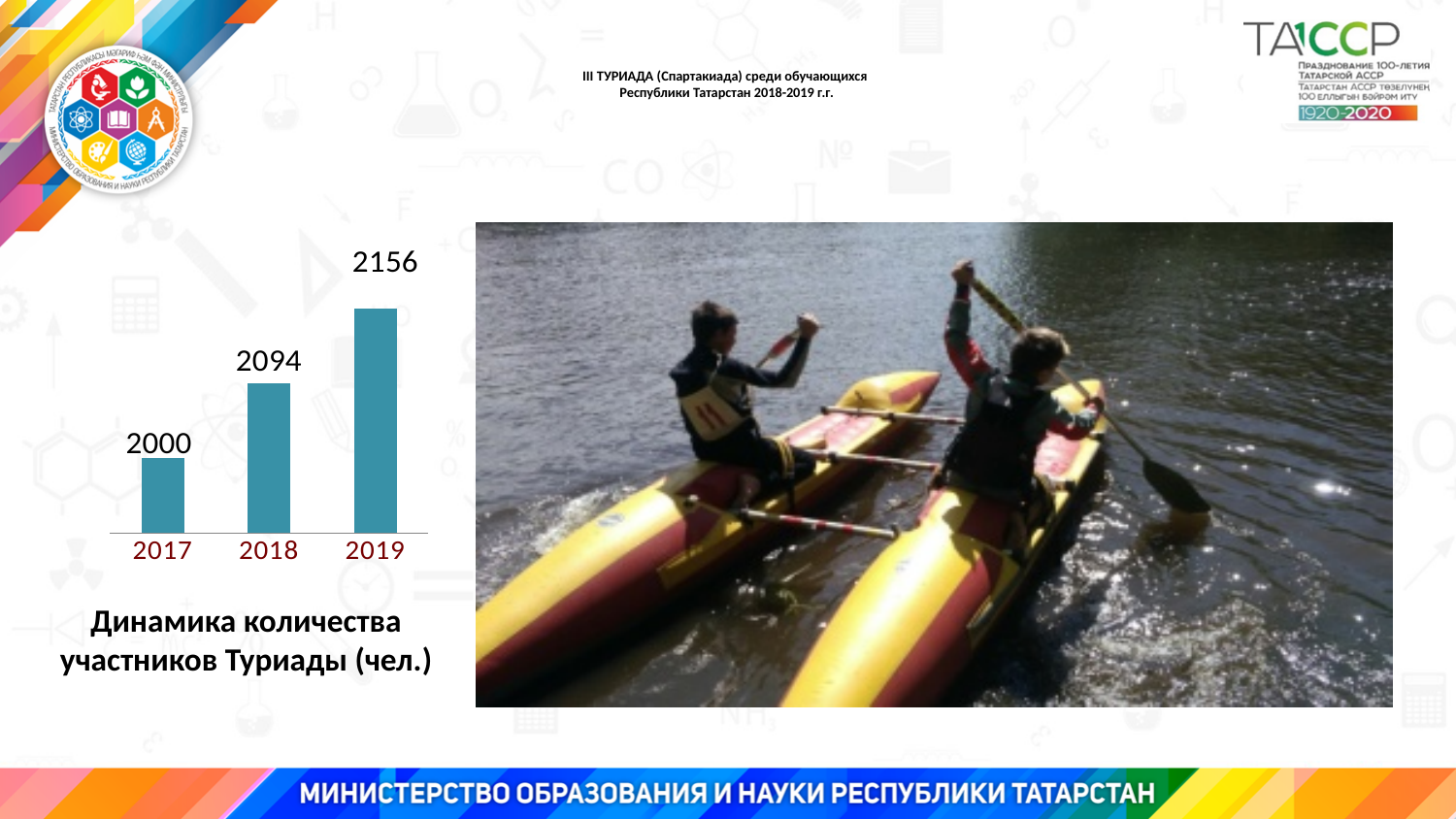
What is the difference in participants between 2018 and 2017? 94 Which year has the highest number of participants? 2019 What is the number of Turiada participants in 2017? 2000 Which year has the lowest number of participants? 2017 Which year had more participants, 2018 or 2019? 2019 How many years are shown on the chart? 3 What is the number of Turiada participants in 2018? 2094 Do the participant numbers rise or fall from 2017 to 2019? Rise What type of chart is shown on the slide? Bar chart By how much did the number of participants increase from 2017 to 2019? 156 What is the number of Turiada participants in 2019? 2156 What is the caption below the chart? Динамика количества участников Туриады (чел.)